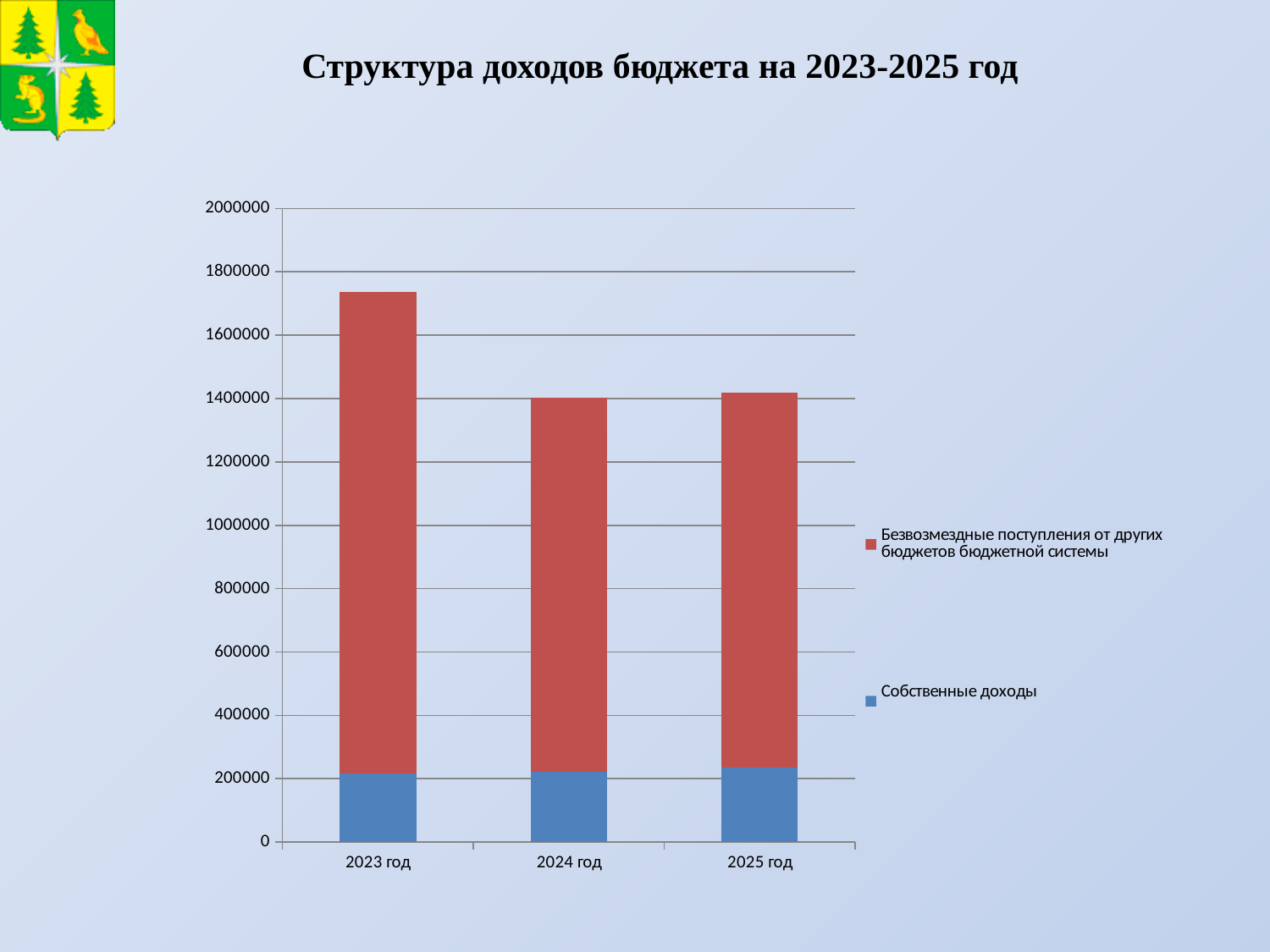
Is the total bar for 2023 год greater or less than 1600000? greater What kind of chart is shown on the slide? Stacked bar chart Is the total bar for 2024 год greater or less than 1600000? less What is the title of the slide? Структура доходов бюджета на 2023-2025 год Which total bar is larger, 2023 год or 2024 год? 2023 год Is the total bar for 2025 год greater or less than 1200000? greater How many years (categories) are shown on the x axis? 3 Does the total bar rise or fall from 2023 год to 2024 год? fall How many series does the legend list? 2 Which series is shown in blue? Собственные доходы Which year has the highest total bar? 2023 год